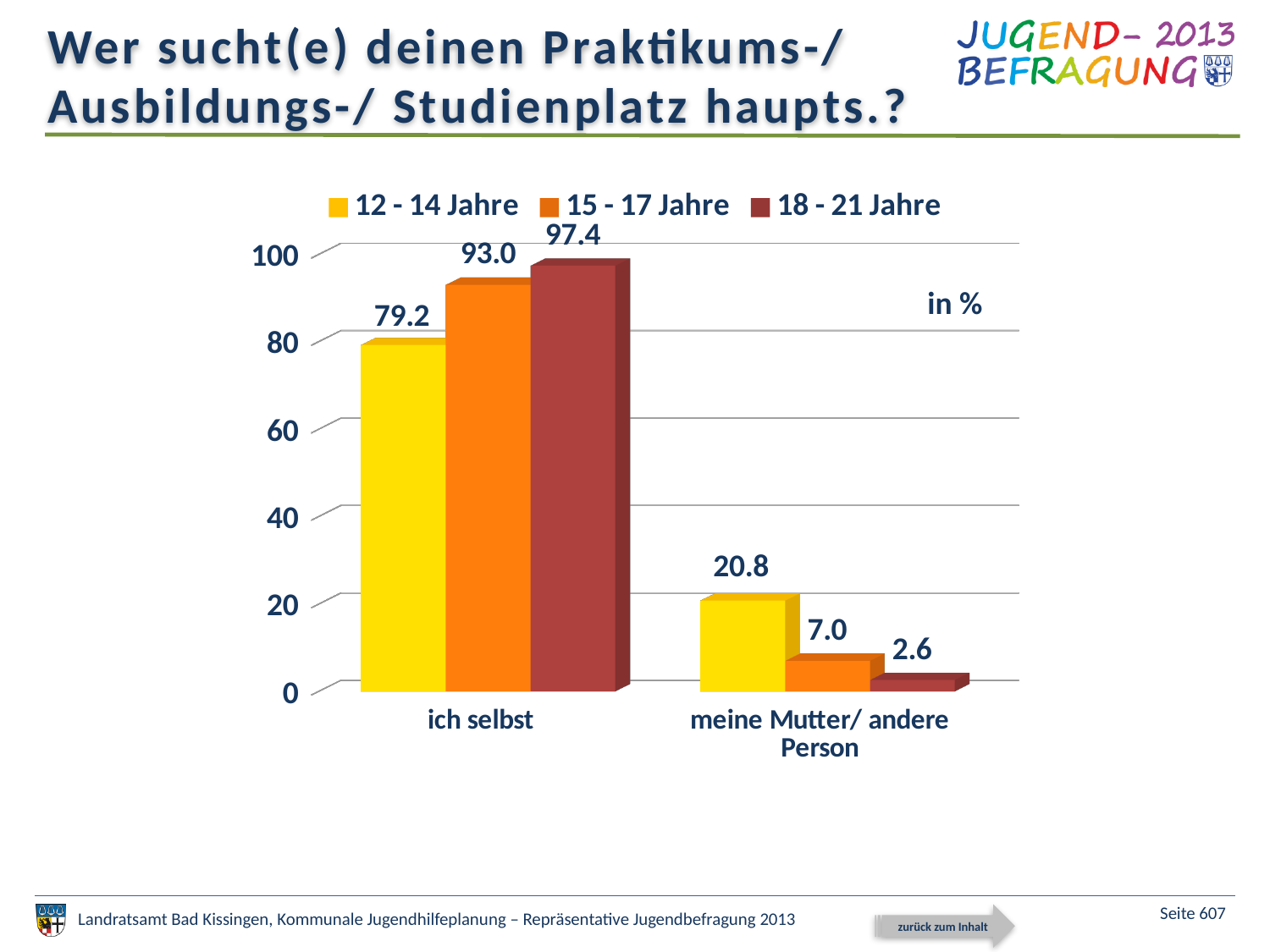
How many series does the legend list? 3 What is the value for 18 - 21 Jahre in the 'meine Mutter/ andere Person' category? 2.6 What kind of chart is shown on the slide? bar chart Which is larger: the 12 - 14 Jahre value for 'ich selbst' or the 12 - 14 Jahre value for 'meine Mutter/ andere Person'? ich selbst What is the value for 15 - 17 Jahre in the 'ich selbst' category? 93.0 What is the difference between the 18 - 21 Jahre and 12 - 14 Jahre values for 'ich selbst'? 18.2 What is the difference between the 12 - 14 Jahre and 15 - 17 Jahre values for 'meine Mutter/ andere Person'? 13.8 Which age group has the lowest value for 'meine Mutter/ andere Person'? 18 - 21 Jahre What is the value for 12 - 14 Jahre in the 'ich selbst' category? 79.2 Which age group has the highest value for 'ich selbst'? 18 - 21 Jahre What unit is indicated for the values in the chart? in % How many categories are shown on the x axis? 2